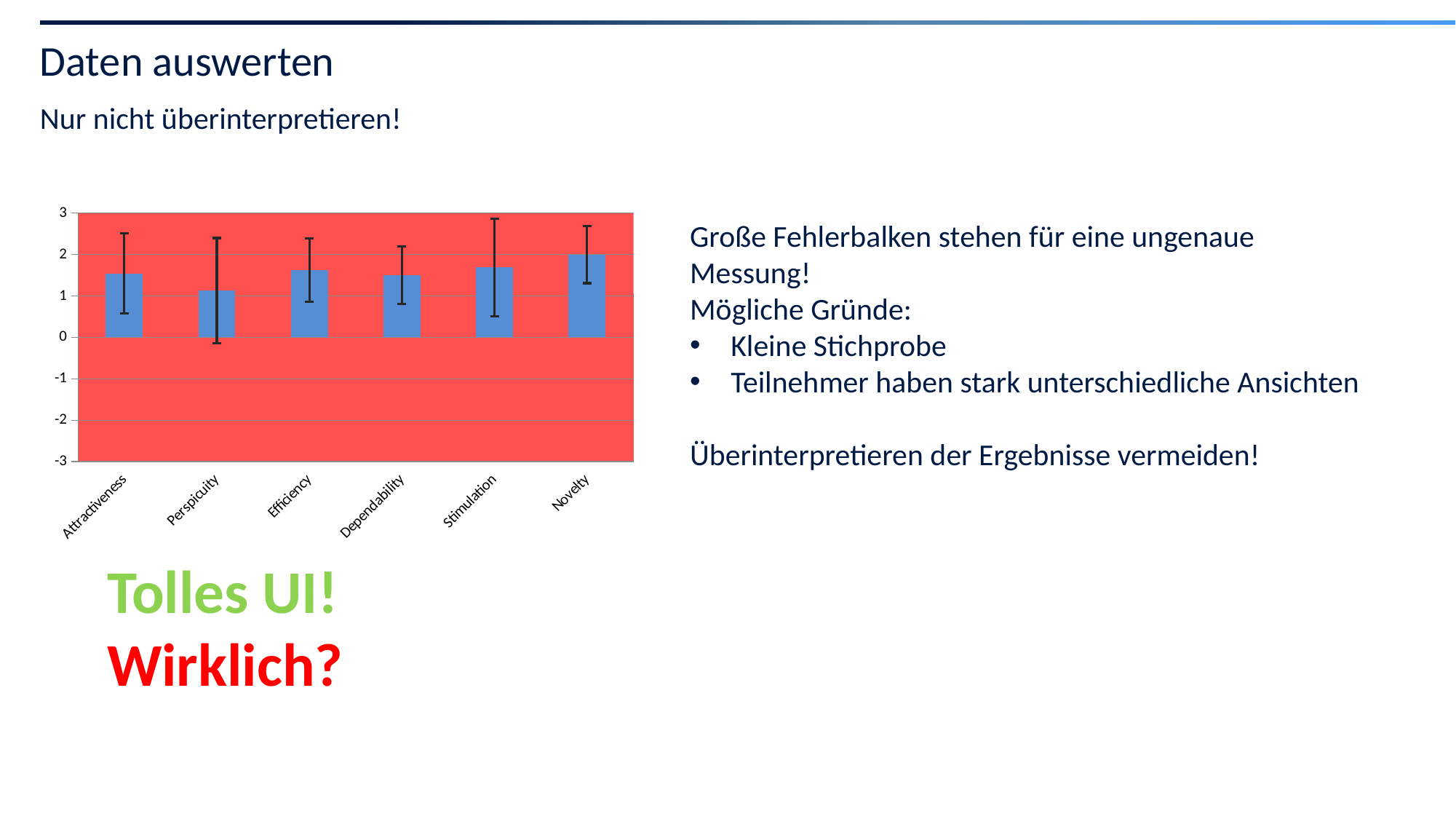
Is the value for Efficiency greater or less than 2? less What colour is the plot area background of the chart? red What is the lowest value shown on the y axis of the chart? -3 How many categories are shown on the x axis of the chart? 6 Is the value for Attractiveness greater or less than 1? greater Which is larger, the value for Novelty or the value for Perspicuity? Novelty Is the value for Stimulation greater or less than 2? less Which category has the highest bar in the chart? Novelty Which is larger, the value for Efficiency or the value for Perspicuity? Efficiency Which category has the lowest bar in the chart? Perspicuity What kind of chart is shown on the slide? bar chart